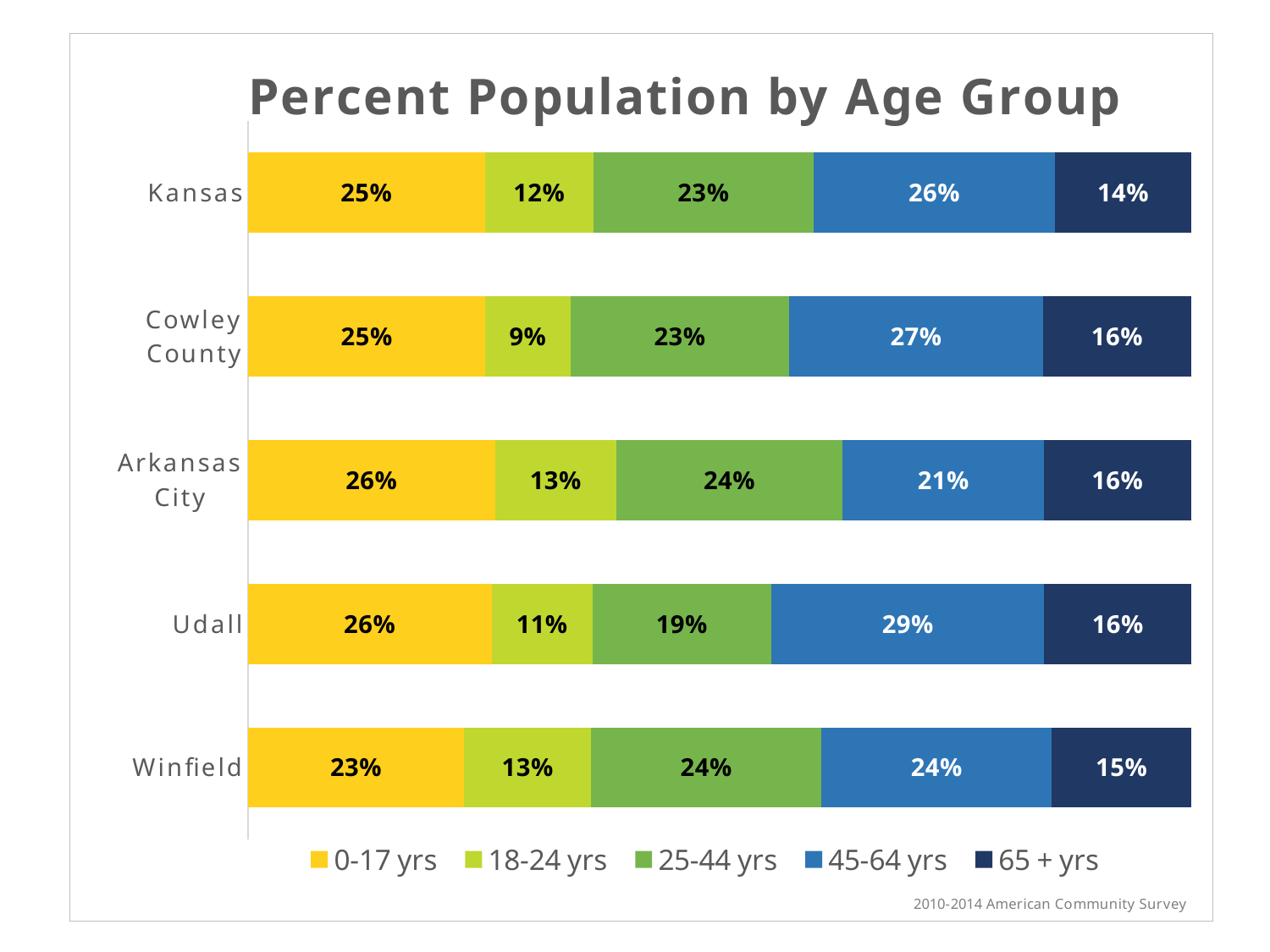
How many percentage points higher is Udall's 45-64 yrs share than Arkansas City's 45-64 yrs share? 8 percentage points What is the value for the 18-24 yrs age group in Cowley County? 9% How many age groups does the legend list? 5 Which area has the highest percentage in the 45-64 yrs age group? Udall What percentage of the Kansas population is in the 45-64 yrs age group? 26% Which area has the lowest percentage in the 18-24 yrs age group? Cowley County What is the 65 + yrs value for Winfield? 15% Which area has the lowest percentage in the 65 + yrs age group? Kansas Which has a larger 0-17 yrs share, Winfield or Kansas? Kansas What type of chart is shown on the slide? Stacked bar chart What percentage of Udall's population is 25-44 yrs? 19% How many areas are shown on the chart? 5